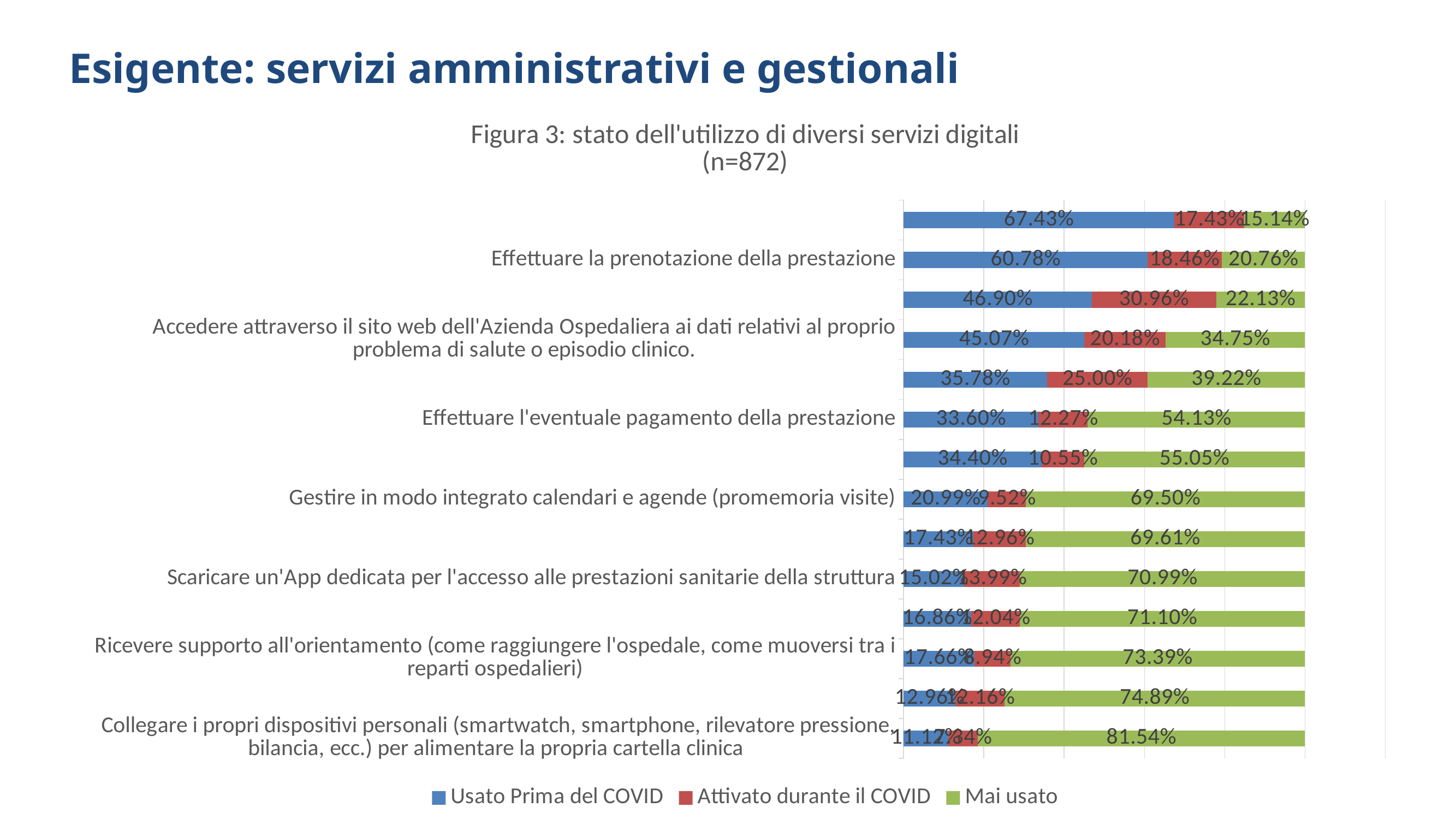
What is the 'Usato Prima del COVID' value for 'Effettuare la prenotazione della prestazione'? 60.78% What is the 'Mai usato' value for 'Scaricare un'App dedicata per l'accesso alle prestazioni sanitarie della struttura'? 70.99% Which is larger: the 'Mai usato' value for 'Gestire in modo integrato calendari e agende (promemoria visite)' or for 'Ricevere supporto all'orientamento (come raggiungere l'ospedale, come muoversi tra i reparti ospedalieri)'? Ricevere supporto all'orientamento (come raggiungere l'ospedale, come muoversi tra i reparti ospedalieri) What is the difference between the 'Usato Prima del COVID' values for 'Effettuare la prenotazione della prestazione' and 'Accedere attraverso il sito web dell'Azienda Ospedaliera ai dati relativi al proprio problema di salute o episodio clinico.'? 15.71% What is the 'Attivato durante il COVID' value for 'Accedere attraverso il sito web dell'Azienda Ospedaliera ai dati relativi al proprio problema di salute o episodio clinico.'? 20.18% What kind of chart is shown on the slide? Stacked bar chart How many series does the legend list? 3 What are the three series named in the legend? Usato Prima del COVID, Attivato durante il COVID, Mai usato What is the 'Mai usato' value for 'Effettuare l'eventuale pagamento della prestazione'? 54.13% Which category has the highest 'Mai usato' value? Collegare i propri dispositivi personali (smartwatch, smartphone, rilevatore pressione, bilancia, ecc.) per alimentare la propria cartella clinica How many bars (categories) are plotted in the chart? 14 What is the title of the chart? Figura 3: stato dell'utilizzo di diversi servizi digitali (n=872)